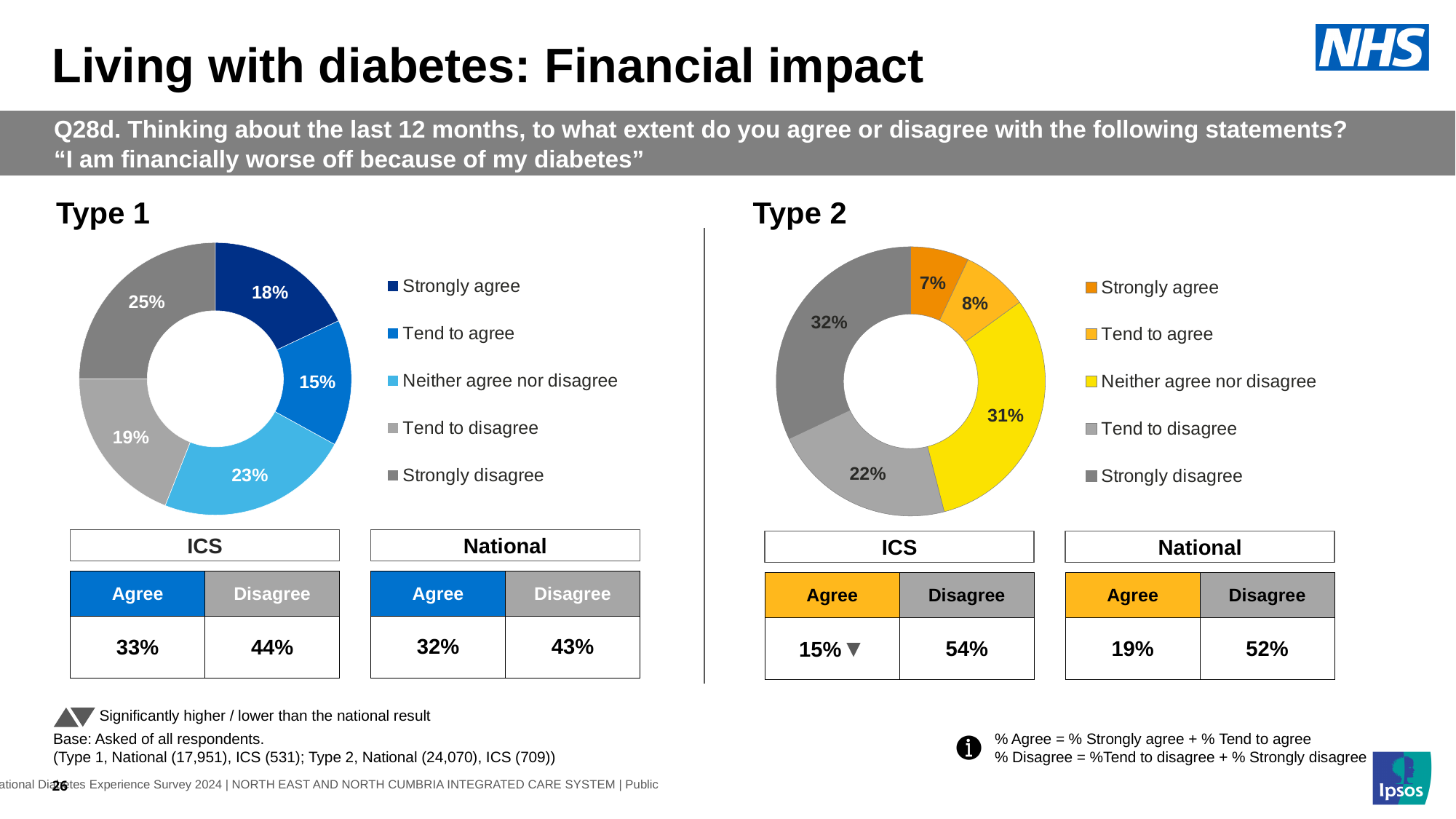
In the Type 2 chart, what colour is the Neither agree nor disagree segment? Yellow In the Type 2 chart, what percentage of respondents said they tend to agree? 8% In the Type 2 chart, which is larger: the Strongly disagree share or the Neither agree nor disagree share? Strongly disagree In the Type 2 chart, what is the difference between the Neither agree nor disagree share and the Tend to disagree share? 9 percentage points In the Type 2 chart, which response category has the smallest share? Strongly agree In the Type 1 chart, what percentage of respondents said they neither agree nor disagree? 23% What kind of chart is used to show the Type 2 results? Donut (pie) chart In the Type 1 chart, which response category has the largest share? Strongly disagree In the Type 2 chart, what percentage of respondents said they strongly disagree? 32% How many response categories does the legend of the Type 1 chart list? 5 In the Type 1 chart, what percentage of respondents said they strongly agree? 18% In the Type 1 chart, what is the difference between the Strongly disagree share and the Tend to agree share? 10 percentage points